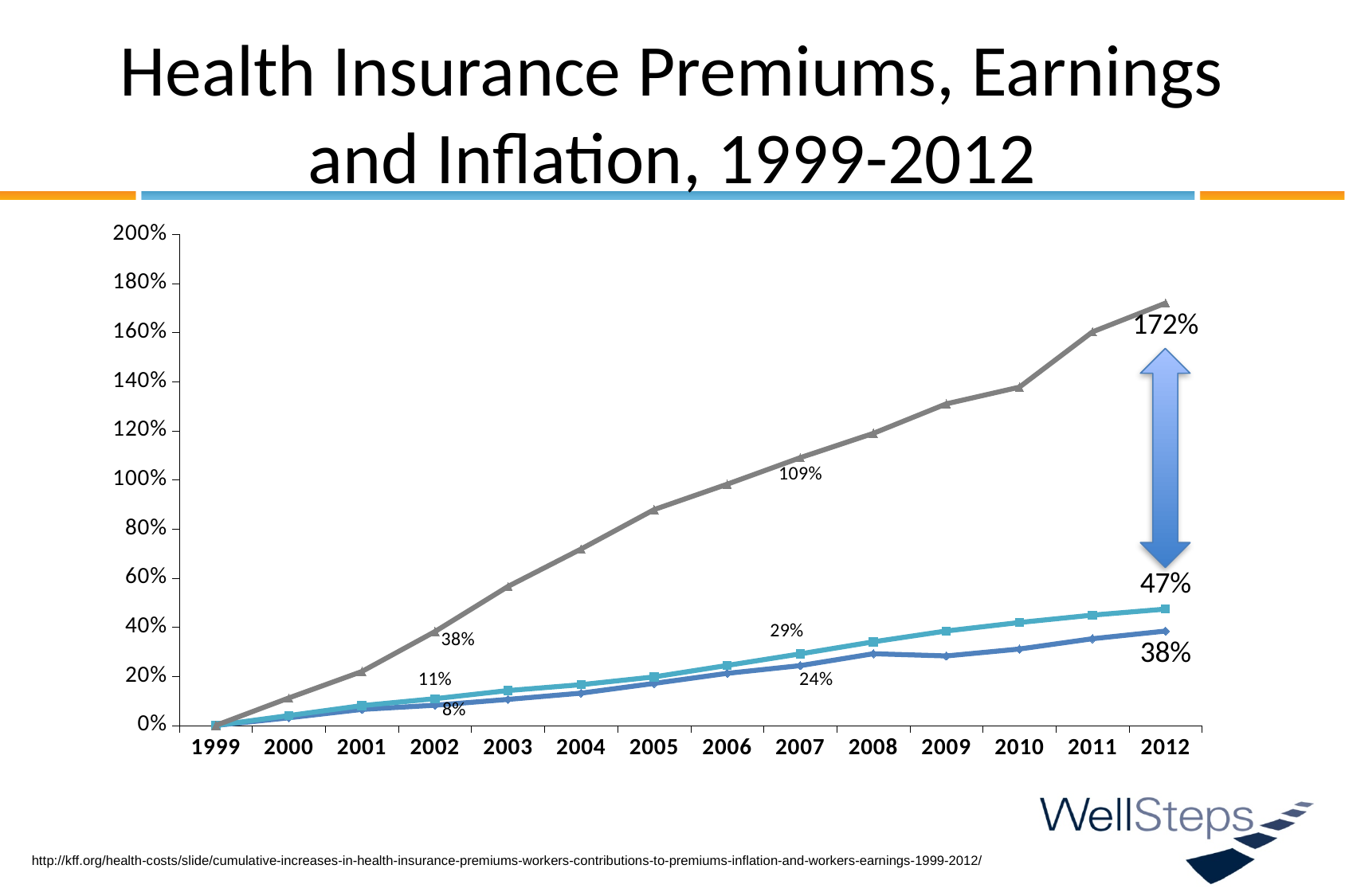
What is the value of the bottom (blue) line in 2012? 38% Is the value of the top (gray) line in 2005 greater or less than 80%? greater What kind of chart is shown on the slide? line chart What is the value of the middle (teal) line in 2012? 47% What is the title of the chart on the slide? Health Insurance Premiums, Earnings and Inflation, 1999-2012 What is the difference between the top (gray) line and the bottom (blue) line in 2002? 30 percentage points In 2007, which is larger: the middle (teal) line at 29% or the bottom (blue) line at 24%? the middle (teal) line What is the value of the top (gray) line in 2012? 172% How many years are shown along the x axis of the chart? 14 What is the value of the top (gray) line in 2007? 109% What is the difference between the top (gray) line and the middle (teal) line in 2012? 125 percentage points Does the top (gray) line rise or fall from 1999 to 2012? rise